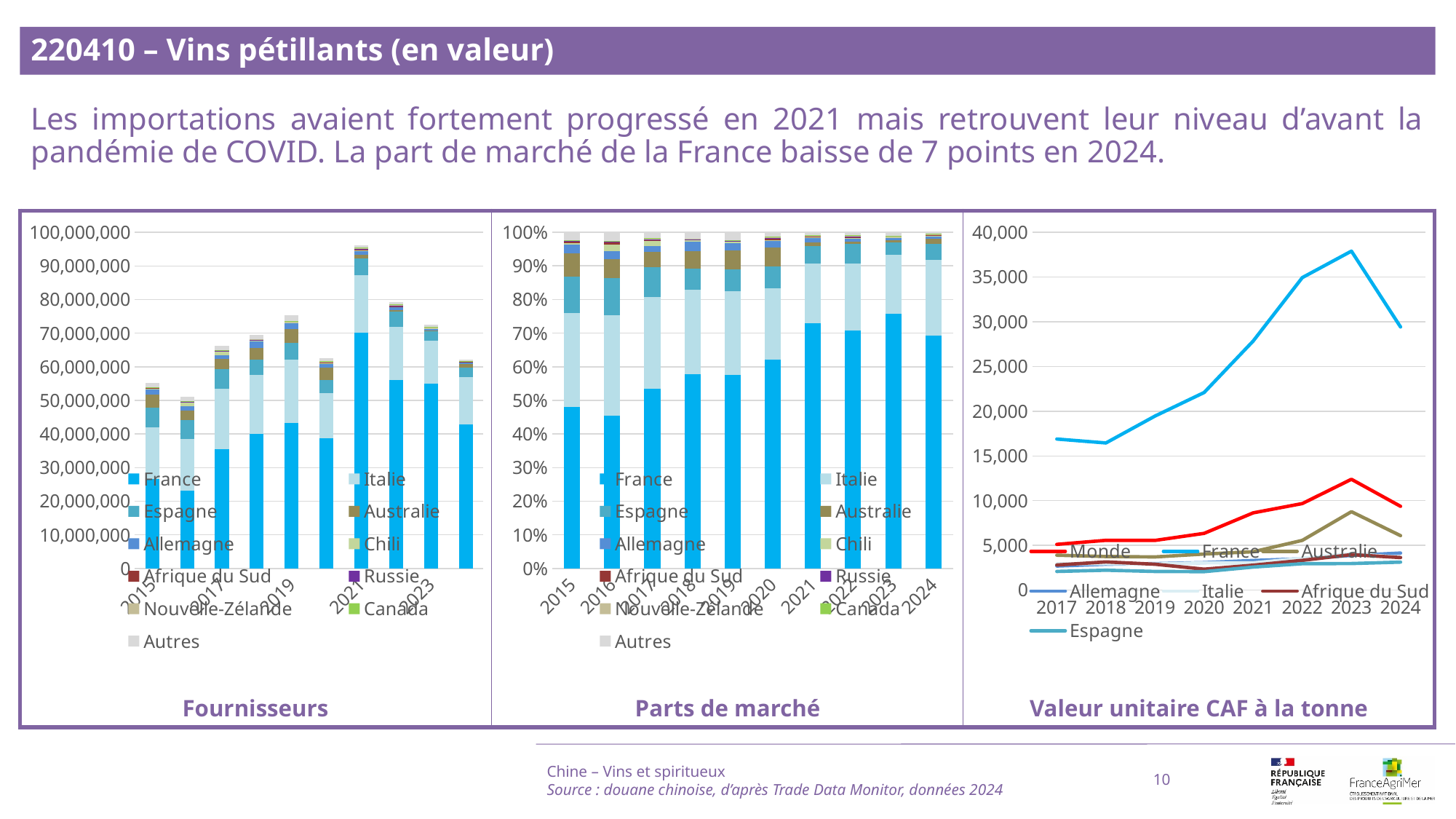
In the 'Fournisseurs' chart, which year has the lowest total bar? 2016 What kind of chart is the 'Valeur unitaire CAF à la tonne' chart? line chart In the 'Valeur unitaire CAF à la tonne' chart, in which year does the France line reach its highest value? 2023 In the 'Fournisseurs' chart, how many series does the legend list? 11 In the 'Valeur unitaire CAF à la tonne' chart, how many series does the legend list? 7 What kind of chart is the 'Fournisseurs' chart? bar chart In the 'Fournisseurs' chart, is the total for 2021 greater or less than 90,000,000? greater In the 'Fournisseurs' chart, which year has the highest total bar? 2021 In the 'Parts de marché' chart, is the France share in 2023 greater or less than 70%? greater In the 'Fournisseurs' chart, how many years are shown on the x axis? 10 In the 'Valeur unitaire CAF à la tonne' chart, is the France value in 2023 greater or less than 35,000? greater